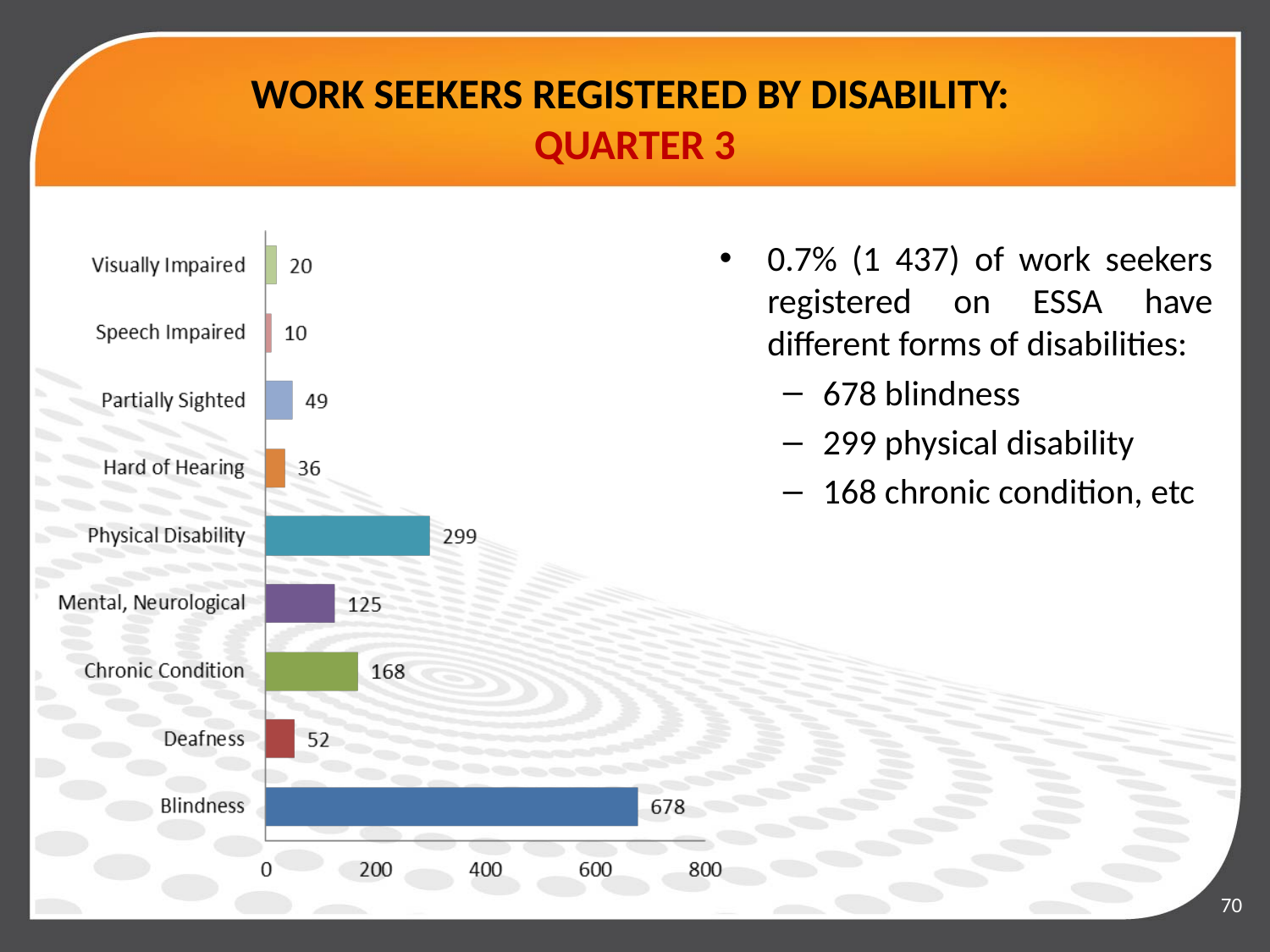
What is the difference between the values for Blindness and Physical Disability? 379 Which category has the highest value? Blindness What is the value for Blindness? 678 What is the value for Hard of Hearing? 36 What is the value for Physical Disability? 299 What is the maximum value shown on the horizontal axis? 800 Which is larger, the value for Deafness or the value for Partially Sighted? Deafness What is the difference between the values for Chronic Condition and Mental, Neurological? 43 Which category has the lowest value? Speech Impaired What kind of chart is shown on the slide? Bar chart Is the value for Physical Disability greater or less than 200? greater How many categories are shown in the chart? 9